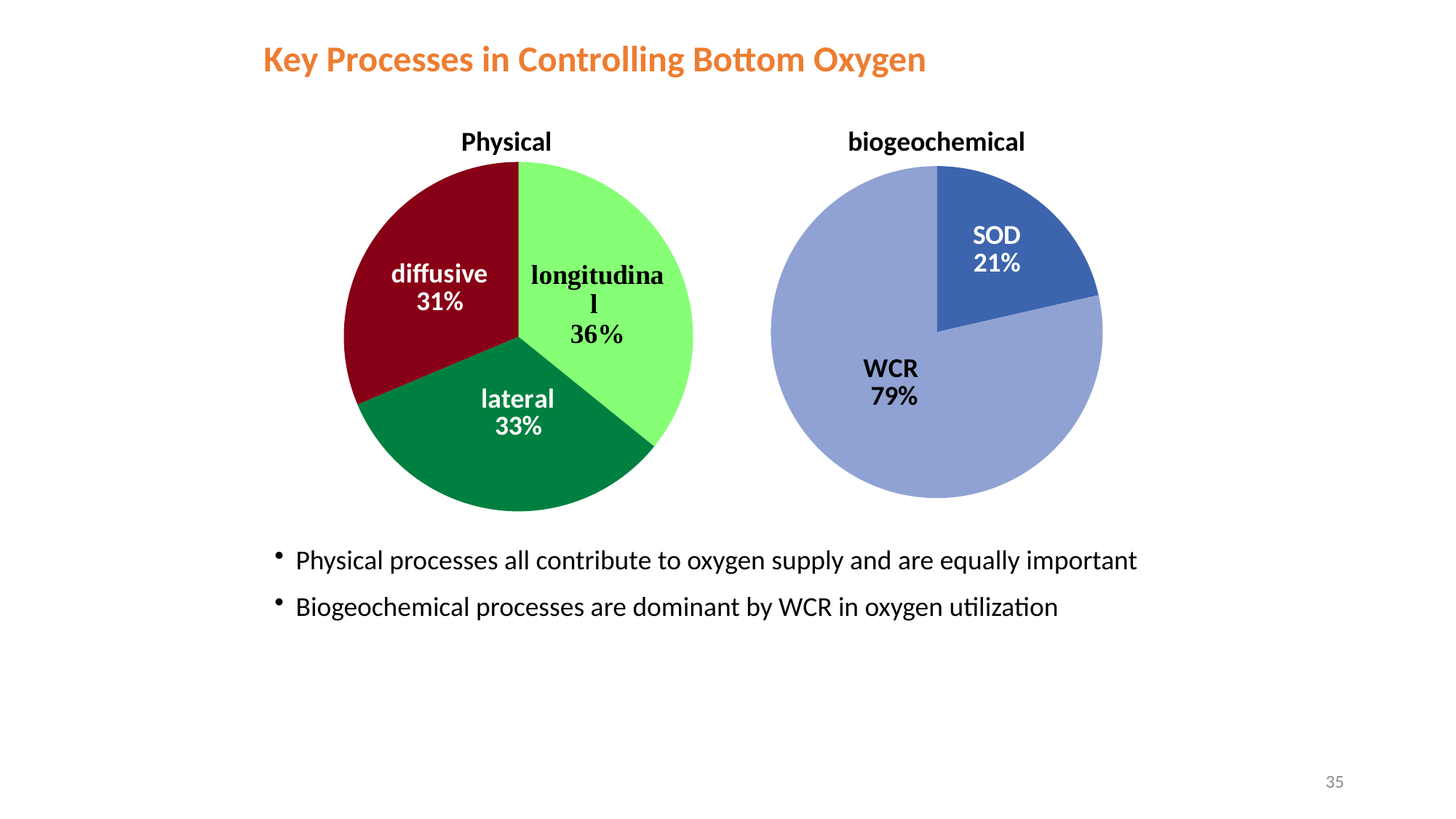
In the biogeochemical pie chart, what share does the SOD slice have? 21% In the Physical pie chart, which is larger, the lateral slice or the diffusive slice? lateral In the biogeochemical pie chart, what share does the WCR slice have? 79% What is the title of the chart on the right? biogeochemical In the Physical pie chart, what share does the longitudinal slice have? 36% In the Physical pie chart, what share does the lateral slice have? 33% In the Physical pie chart, which slice is the largest? longitudinal In the Physical pie chart, which slice is the smallest? diffusive In the Physical pie chart, what share does the diffusive slice have? 31% What type of chart is the biogeochemical chart? pie chart How many slices does the Physical pie chart have? 3 In the biogeochemical pie chart, what is the difference between the WCR and SOD shares? 58%